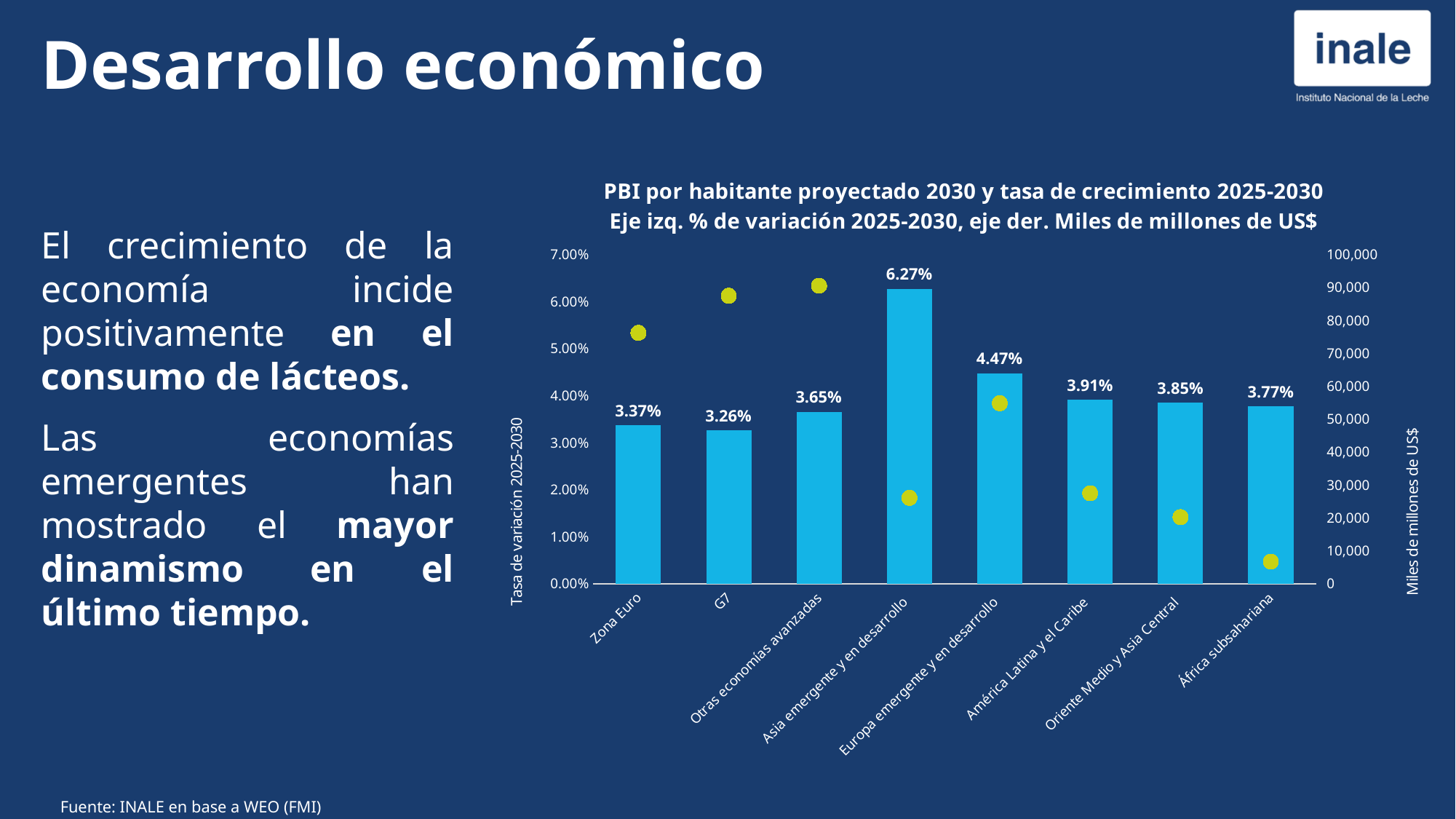
What is the growth rate shown for América Latina y el Caribe? 3.91% What is the title of the chart? PBI por habitante proyectado 2030 y tasa de crecimiento 2025-2030 Which region has the lowest growth rate 2025-2030 in the chart? G7 What is the growth rate (tasa de variación 2025-2030) shown for Asia emergente y en desarrollo? 6.27% Is the projected GDP per capita (right axis, yellow dot) for Asia emergente y en desarrollo greater or less than 30,000? less Is the projected GDP per capita (right axis, yellow dot) for África subsahariana greater or less than 10,000? less Which has a higher growth rate, Oriente Medio y Asia Central or África subsahariana? Oriente Medio y Asia Central Is the projected GDP per capita (right axis, yellow dot) for Zona Euro greater or less than 70,000? greater Which region has the highest growth rate 2025-2030 in the chart? Asia emergente y en desarrollo What is the growth rate shown for G7? 3.26% How many regions are shown on the x axis of the chart? 8 What is the difference between the growth rates of Asia emergente y en desarrollo and Europa emergente y en desarrollo? 1.80%